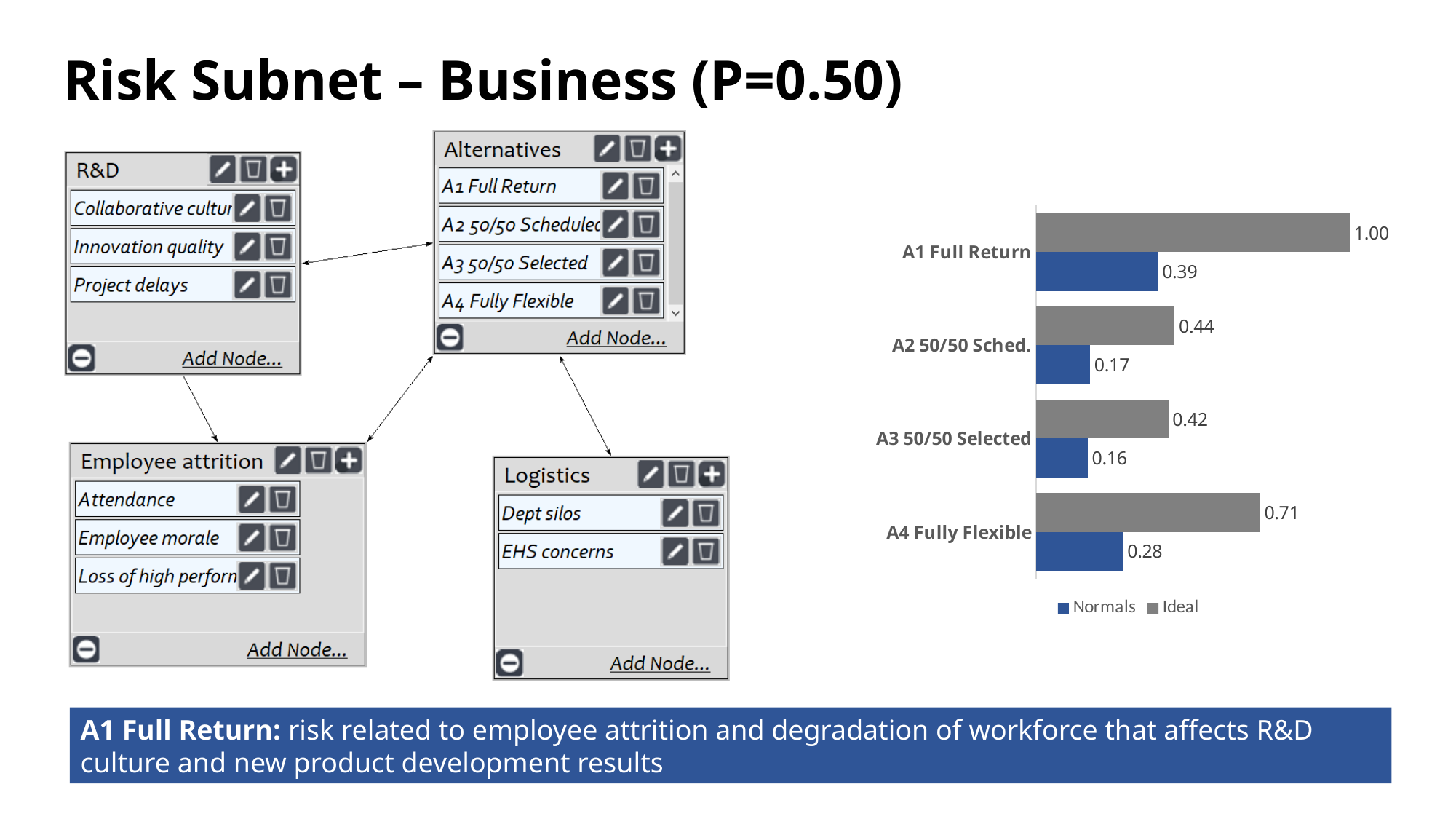
What is the Ideal value for A1 Full Return? 1.00 What is the Normals value for A4 Fully Flexible? 0.28 How many series does the chart legend list? 2 Which alternative has the highest Ideal value? A1 Full Return Which is larger, the Normals value for A1 Full Return or the Normals value for A4 Fully Flexible? A1 Full Return What type of chart is shown on the right of the slide? Bar chart What is the Normals value for A2 50/50 Sched.? 0.17 What is the difference between the Ideal and Normals values for A2 50/50 Sched.? 0.27 Which alternative has the lowest Normals value? A3 50/50 Selected What is the difference between the Ideal values for A1 Full Return and A4 Fully Flexible? 0.29 How many alternatives are plotted in the bar chart? 4 What is the Ideal value for A3 50/50 Selected? 0.42